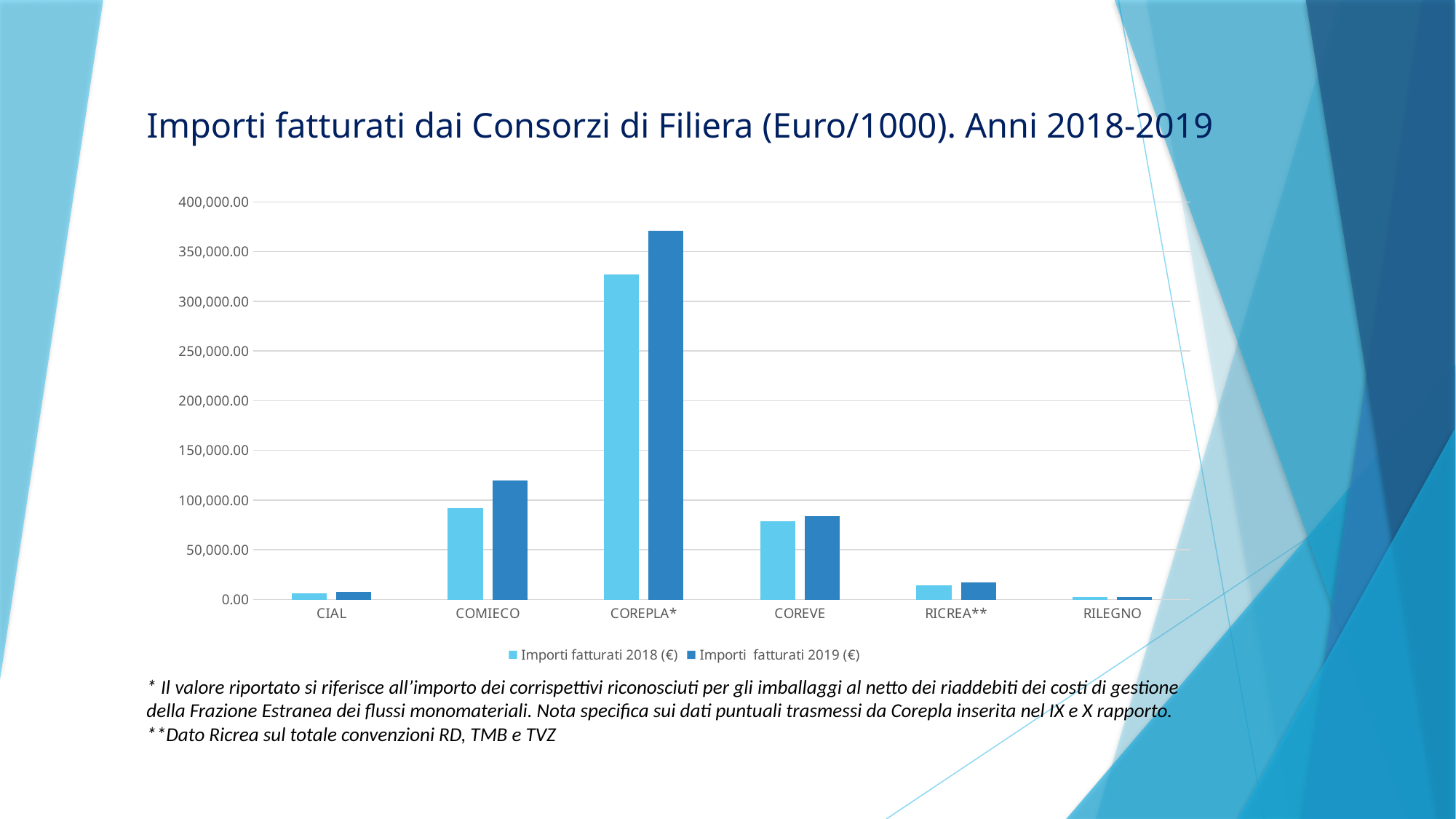
Which consortium has the highest value for Importi fatturati 2019 (€)? COREPLA* Is the value for COREPLA* in Importi fatturati 2018 (€) greater or less than 350,000.00? less Which consortium has the larger value for Importi fatturati 2019 (€): COMIECO or COREVE? COMIECO Is the value for COREPLA* in Importi fatturati 2019 (€) greater or less than 350,000.00? greater What is the title of the chart? Importi fatturati dai Consorzi di Filiera (Euro/1000). Anni 2018-2019 Is the value for COREVE in Importi fatturati 2018 (€) greater or less than 50,000.00? greater How many series does the legend list? 2 What kind of chart is shown on the slide? bar chart Which consortium has the lowest value for Importi fatturati 2018 (€)? RILEGNO How many consortia (categories) are shown on the x axis? 6 Which is larger for COMIECO: Importi fatturati 2018 (€) or Importi fatturati 2019 (€)? Importi fatturati 2019 (€)